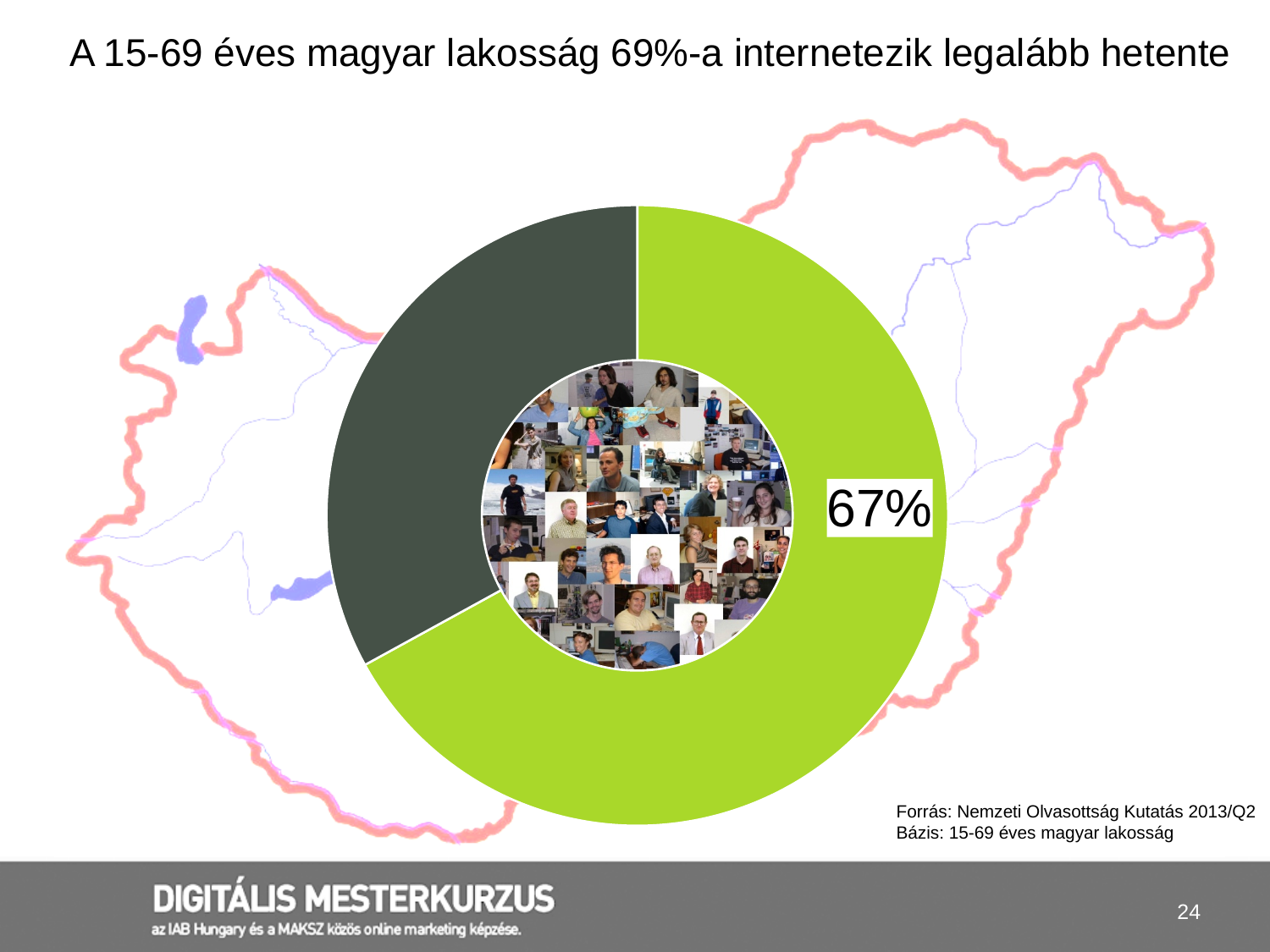
Which slice of the doughnut chart is the smallest? the dark grey slice How many slices does the doughnut chart have? 2 What value is printed on the green slice of the doughnut chart? 67% Which slice of the doughnut chart is larger, the green one or the dark grey one? the green one What colour is the slice that carries the 67% label? green What is the title of the slide above the chart? A 15-69 éves magyar lakosság 69%-a internetezik legalább hetente Is the dark grey slice's share greater or less than 50%? less What share of the doughnut does the green slice represent? 67% What kind of chart is shown on the slide? doughnut (pie) chart Is the green slice's share greater or less than 50%? greater Which slice of the doughnut chart is the largest? the green slice (67%)